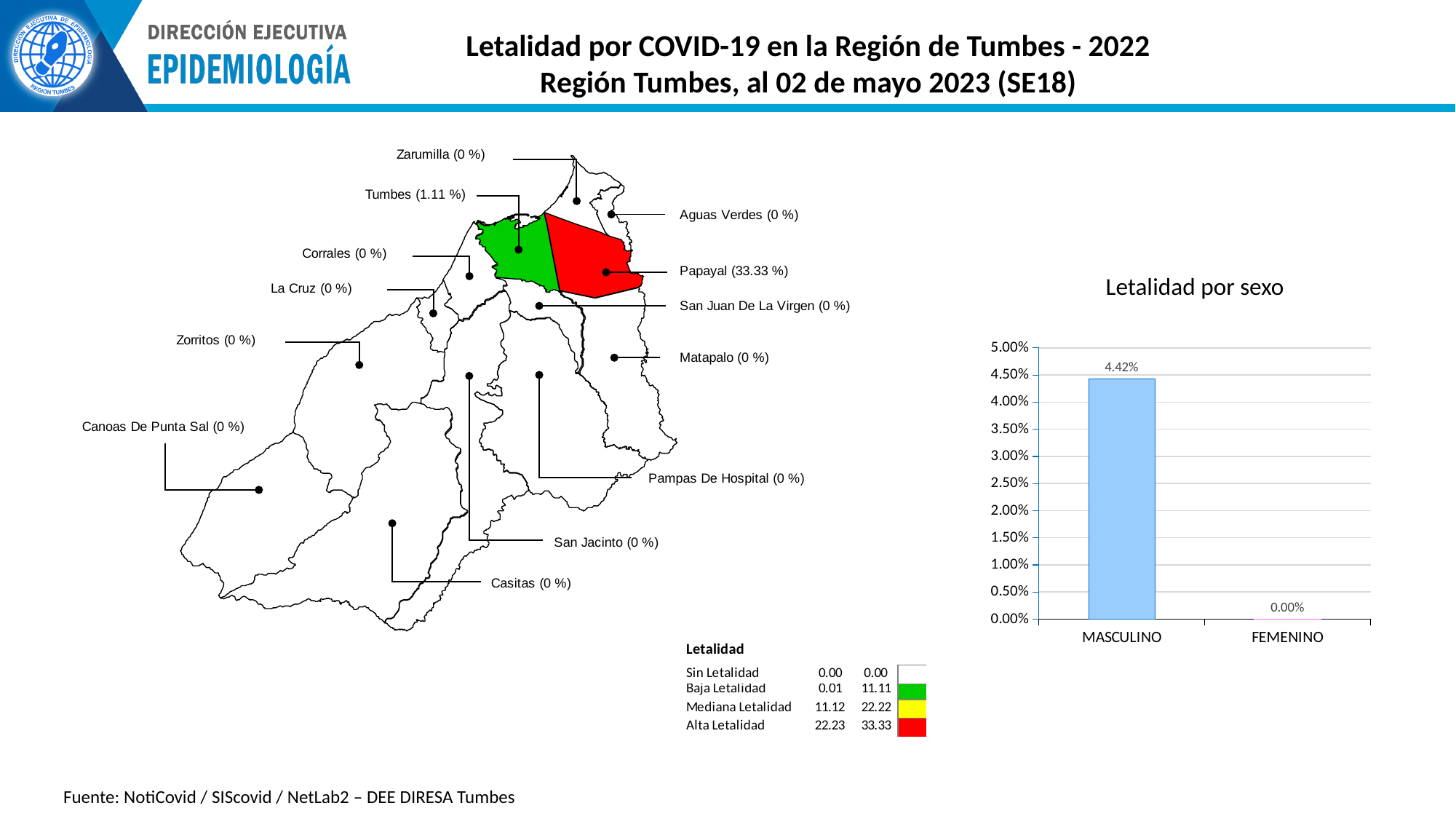
What kind of chart is 'Letalidad por sexo'? bar chart How many categories are shown in the 'Letalidad por sexo' chart? 2 In the 'Letalidad por sexo' chart, what is the value for MASCULINO? 4.42% In the 'Letalidad por sexo' chart, which category has the highest value? MASCULINO On the map on the left, what is the lethality value shown for Papayal? 33.33 % In the 'Letalidad por sexo' chart, which category has the lowest value? FEMENINO On the map on the left, which district has the highest lethality value? Papayal On the map on the left, what is the lethality value shown for Tumbes? 1.11 % In the 'Letalidad por sexo' chart, what is the difference between the MASCULINO and FEMENINO values? 4.42% In the 'Letalidad por sexo' chart, is the value for MASCULINO greater or less than 4.00%? greater In the 'Letalidad por sexo' chart, what is the value for FEMENINO? 0.00% What is the title of the chart on the right side of the slide? Letalidad por sexo